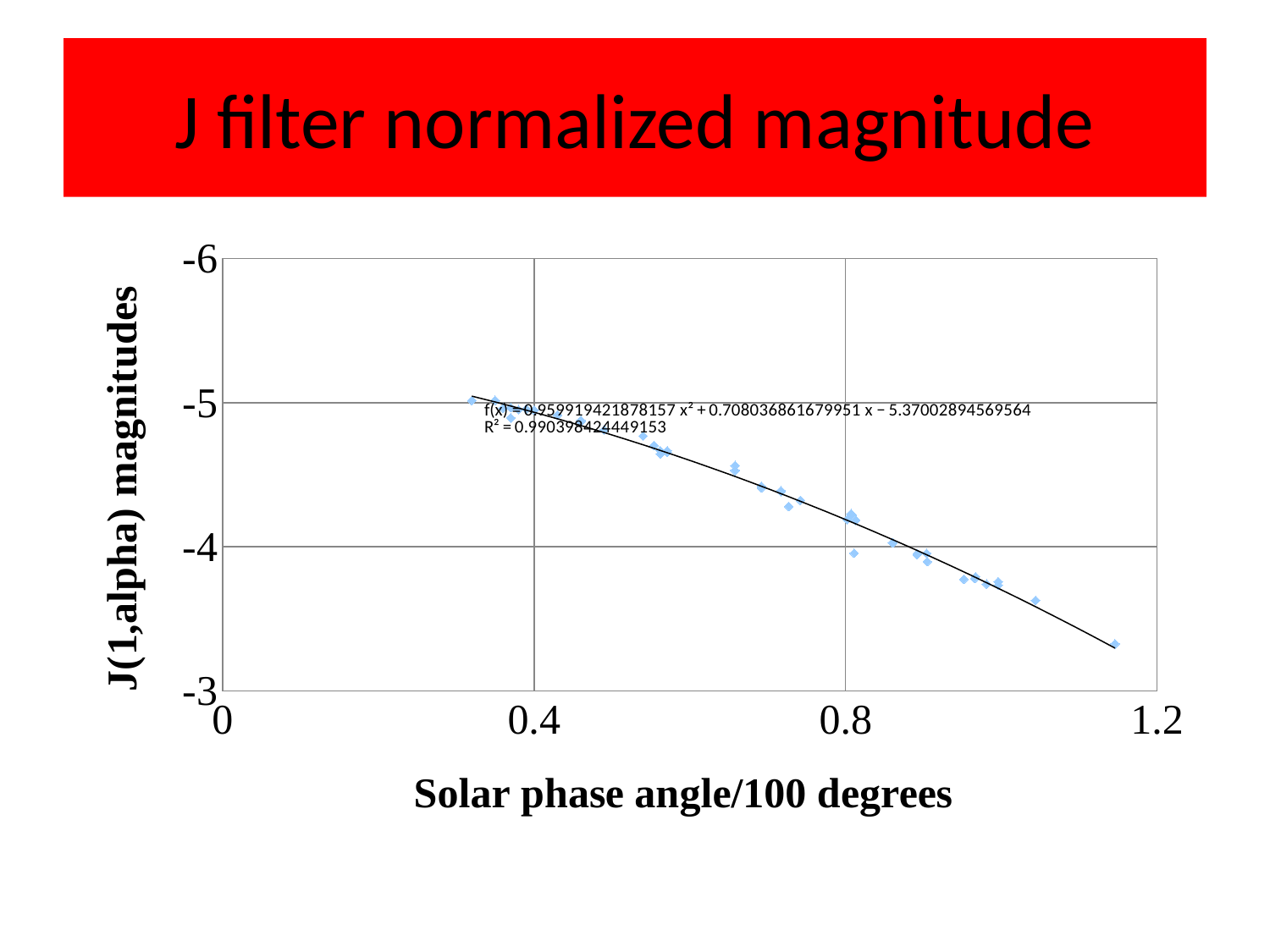
What is the largest value shown on the x axis? 1.2 Which value is shown at the top of the y axis? -6 What is the constant term in the fitted equation f(x) printed on the chart? −5.37002894569564 Is the J(1,alpha) magnitude of the point plotted at a solar phase angle of about 1.15 greater or less than -4? greater What is the coefficient of x² in the fitted equation f(x) printed on the chart? 0.959919421878157 What is the coefficient of x in the fitted equation f(x) printed on the chart? 0.708036861679951 What is the title of the chart on the slide? J filter normalized magnitude What is the label of the x axis? Solar phase angle/100 degrees Is the J(1,alpha) magnitude of the points plotted at a solar phase angle of about 0.55 greater or less than -4? less What R² value is printed on the chart for the fitted curve? 0.990398424449153 What kind of chart is shown on the slide? Scatter chart As the solar phase angle increases from about 0.3 to about 1.15, do the plotted J(1,alpha) magnitude values increase or decrease numerically (from about -5 toward about -3.3)? increase